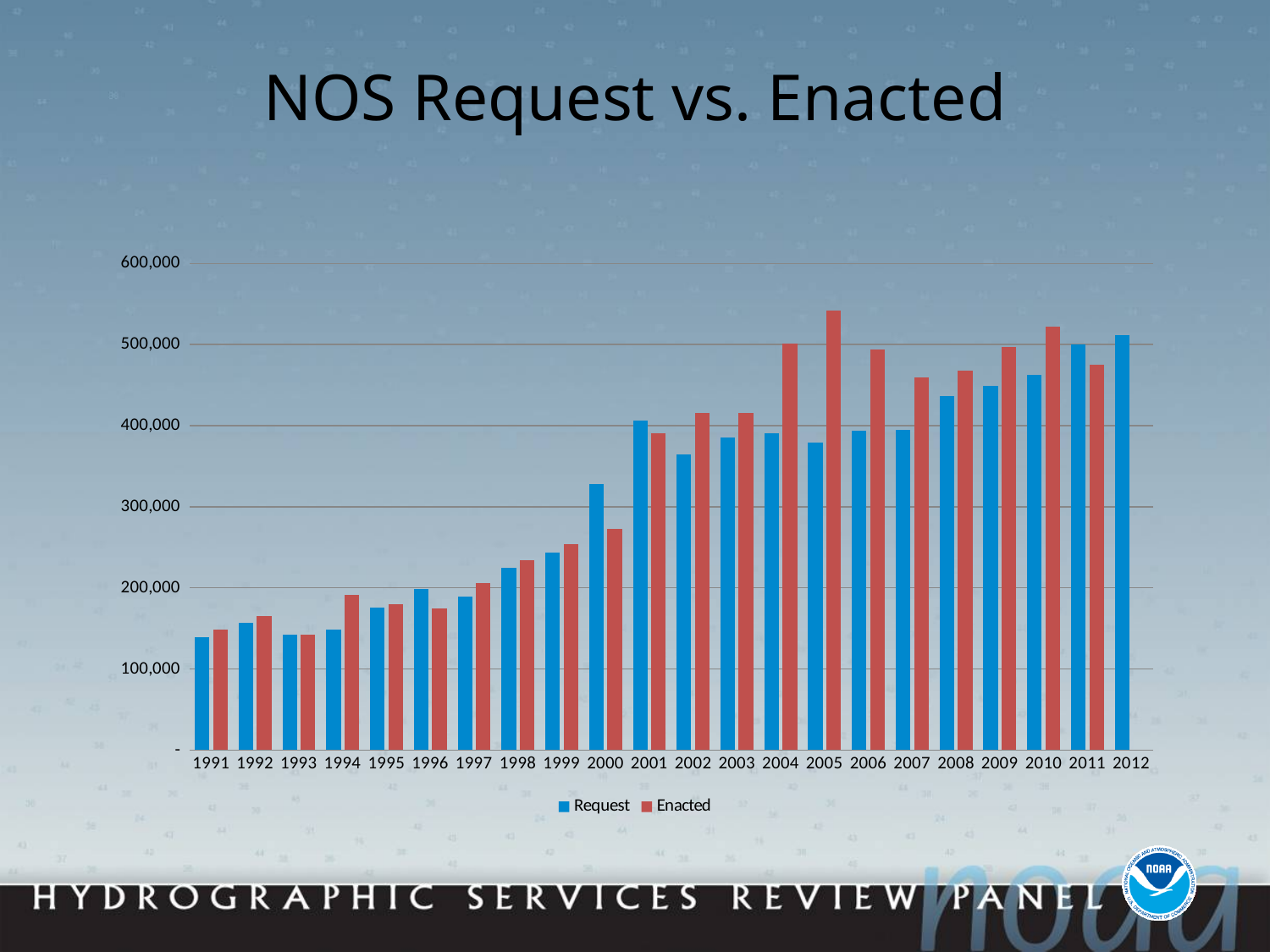
How many years are shown along the x axis? 22 Overall, do the Request values rise or fall from 1991 to 2012? rise How many series does the legend list? 2 Is the Enacted value for 2000 greater or less than 300,000? less Is the Enacted value for 2005 greater or less than 500,000? greater Is the Request value for 2000 greater or less than 300,000? greater In which year is the Enacted value highest? 2005 What kind of chart is shown on the slide? bar chart For 2011, which is larger, Request or Enacted? Request For 2005, which is larger, Request or Enacted? Enacted